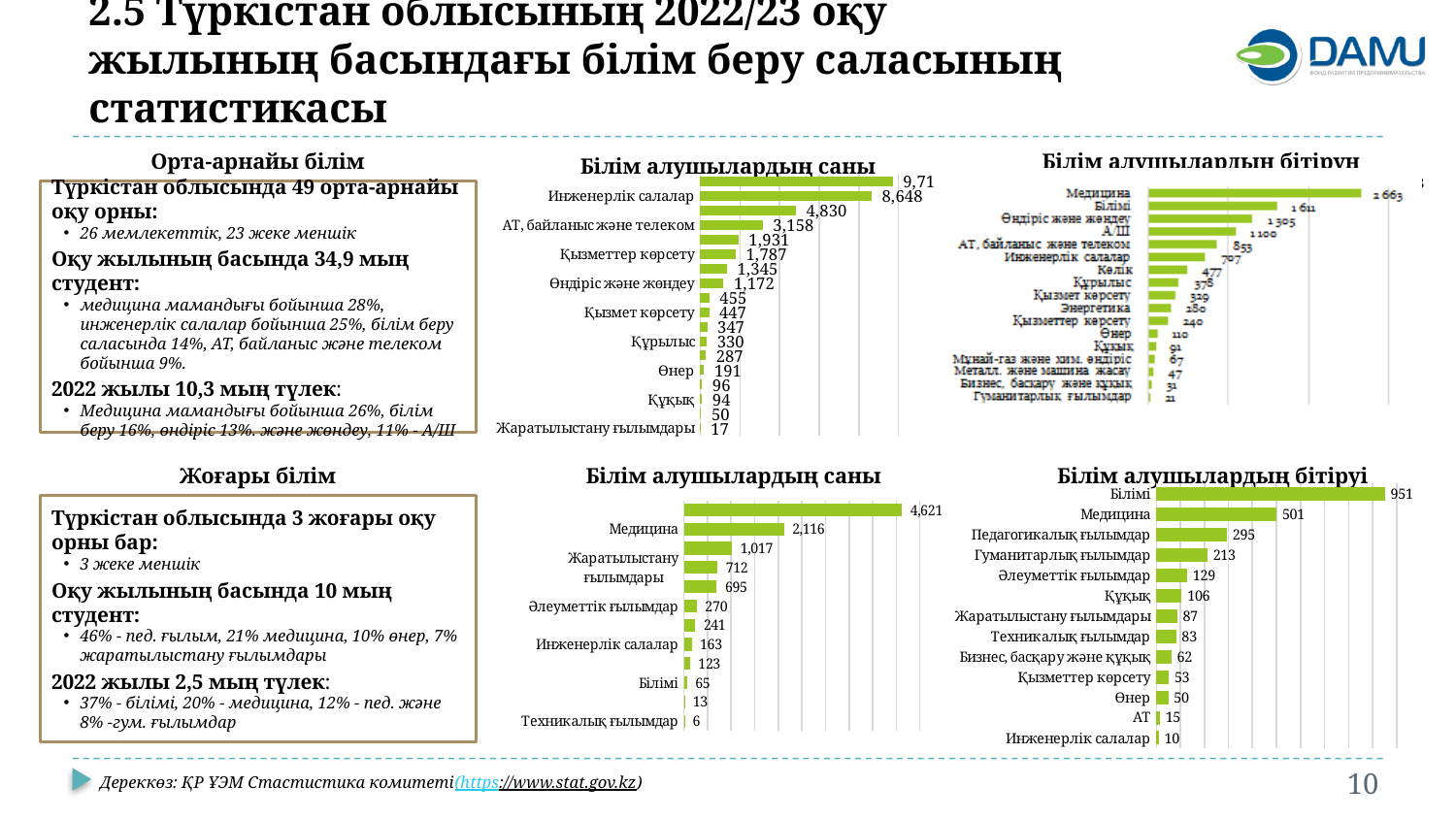
In the top-right chart (Білім алушылардың бітіруі, Орта-арнайы білім), what is the value for Медицина? 2 663 How many categories are shown in the bottom-right chart (Білім алушылардың бітіруі, Жоғары білім)? 13 In the bottom-middle chart (Білім алушылардың саны, Жоғары білім), what is the value for Медицина? 2,116 In the bottom-right chart (Білім алушылардың бітіруі, Жоғары білім), what is the difference between Медицина and Педагогикалық ғылымдар? 206 In the bottom-right chart (Білім алушылардың бітіруі, Жоғары білім), which is larger: Құқық or Жаратылыстану ғылымдары? Құқық What type of chart is the bottom-right chart (Білім алушылардың бітіруі, Жоғары білім)? Bar chart In the bottom-middle chart (Білім алушылардың саны, Жоғары білім), what is the value for Техникалық ғылымдар? 6 In the bottom-right chart (Білім алушылардың бітіруі, Жоғары білім), which category has the highest value? Білімі In the bottom-right chart (Білім алушылардың бітіруі, Жоғары білім), what is the value for Өнер? 50 In the top-right chart (Білім алушылардың бітіруі, Орта-арнайы білім), which category has the highest value? Медицина In the bottom-right chart (Білім алушылардың бітіруі, Жоғары білім), what is the value for Білімі? 951 In the bottom-right chart (Білім алушылардың бітіруі, Жоғары білім), which category has the lowest value? Инженерлік салалар